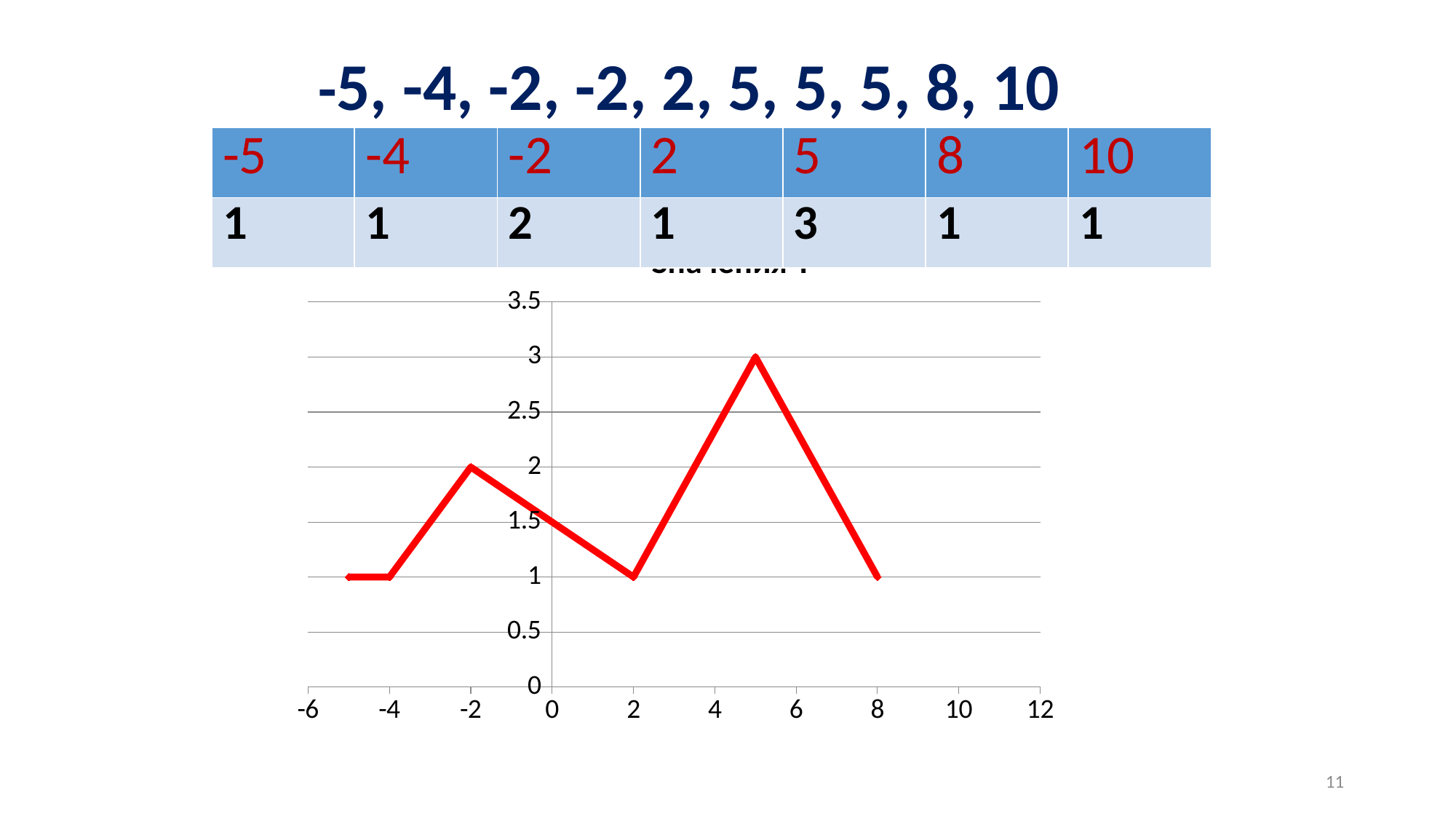
Is the peak value of the line greater or less than 2.5? greater Does the line rise or fall between x = 2 and x = 5? rises What is the value of the line at x = 2? 1 What is the lowest value reached by the line? 1 What is the value of the line at x = -4? 1 What is the value of the line at x = 8? 1 What kind of chart is shown on the slide? line chart What is the difference between the peak value of the line and the value at x = 2? 2 What is the highest value reached by the line? 3 Which has the larger value on the line: x = -2 or x = 2? x = -2 What is the value of the line at x = -2? 2 What colour is the plotted line? red